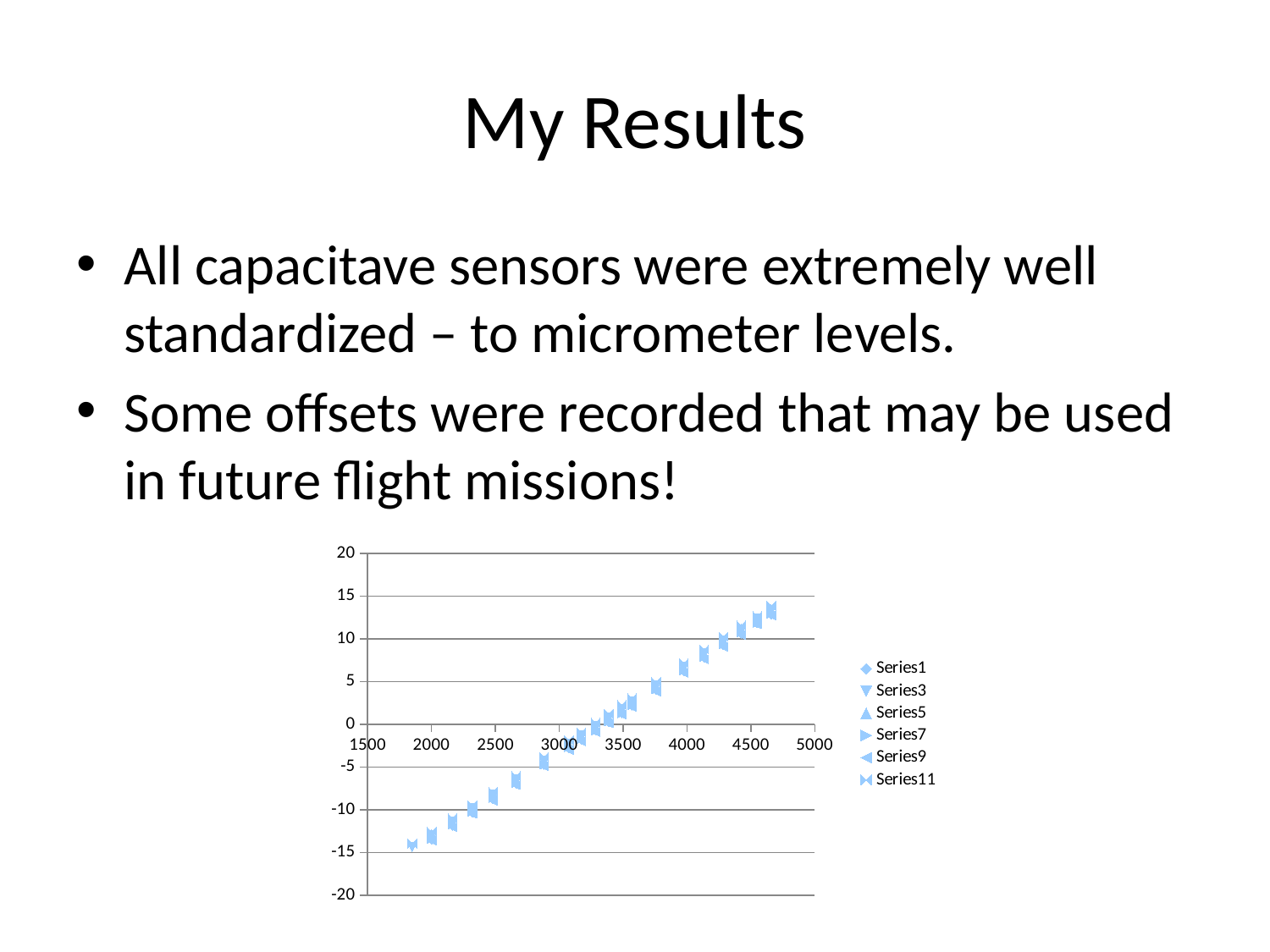
Are the plotted values near x = 3000 greater or less than 0? less What is the last series name listed in the chart's legend? Series11 Do the plotted values rise or fall as the x-axis value increases? rise Are the plotted values near x = 4000 greater or less than 5? greater Are the plotted values near x = 4500 greater or less than 10? greater What kind of chart is shown on the slide? scatter chart What is the first series name listed in the chart's legend? Series1 How many series does the chart's legend list? 6